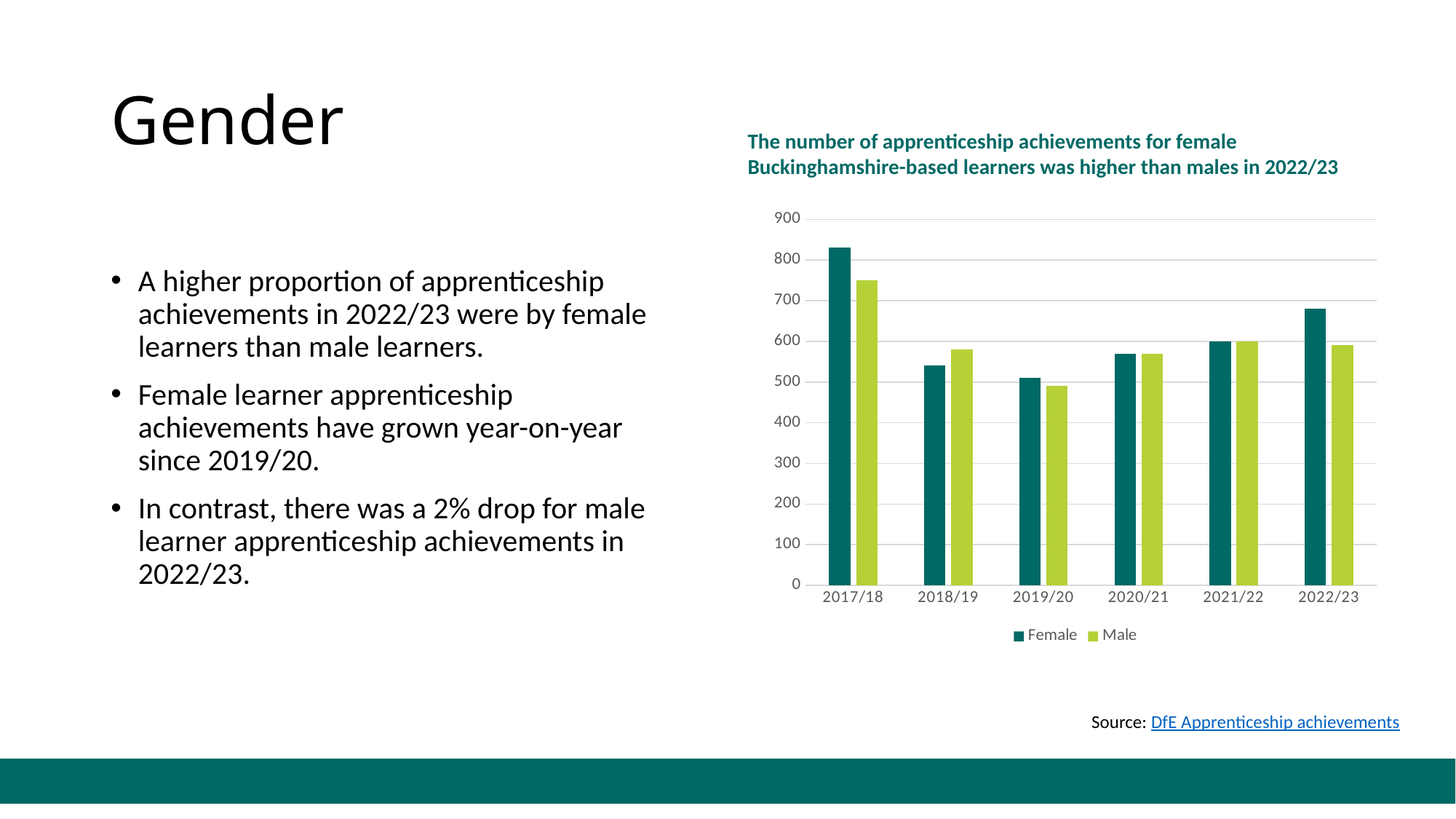
In which year is the Male value highest? 2017/18 What kind of chart is shown on the slide? Bar chart Which series is shown in dark teal in the chart's legend? Female Is the Female value for 2017/18 greater or less than 800? greater Is the Male value for 2019/20 greater or less than 500? less In 2022/23, which series has the larger value, Female or Male? Female How many academic years are shown on the x axis of the chart? 6 In which year is the Male value lowest? 2019/20 In 2018/19, which series has the larger value, Female or Male? Male How many series does the chart's legend list? 2 In which year is the Female value lowest? 2019/20 In which year is the Female value highest? 2017/18